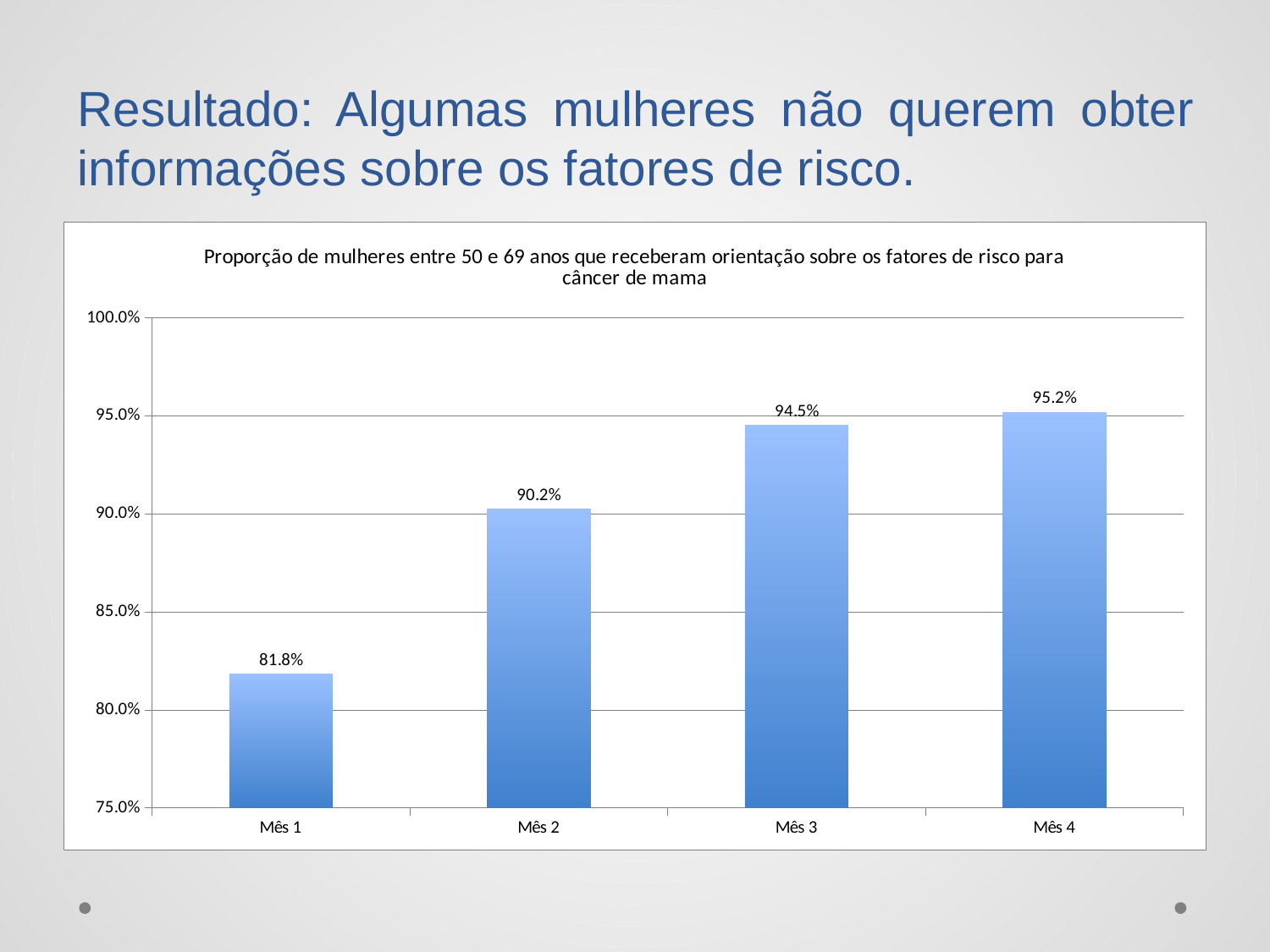
What is the value for Mês 1? 81.8% What is the difference between the values for Mês 2 and Mês 1? 8.4% What kind of chart is shown on the slide? bar chart How many months are shown on the x axis? 4 Which month has the highest value? Mês 4 What is the value for Mês 4? 95.2% What is the value for Mês 3? 94.5% Is the value for Mês 2 greater or less than 85.0%? greater Which month has the lowest value? Mês 1 What is the difference between the values for Mês 4 and Mês 3? 0.7% Do the values rise or fall from Mês 1 to Mês 4? rise Which is larger, the value for Mês 2 or the value for Mês 3? Mês 3